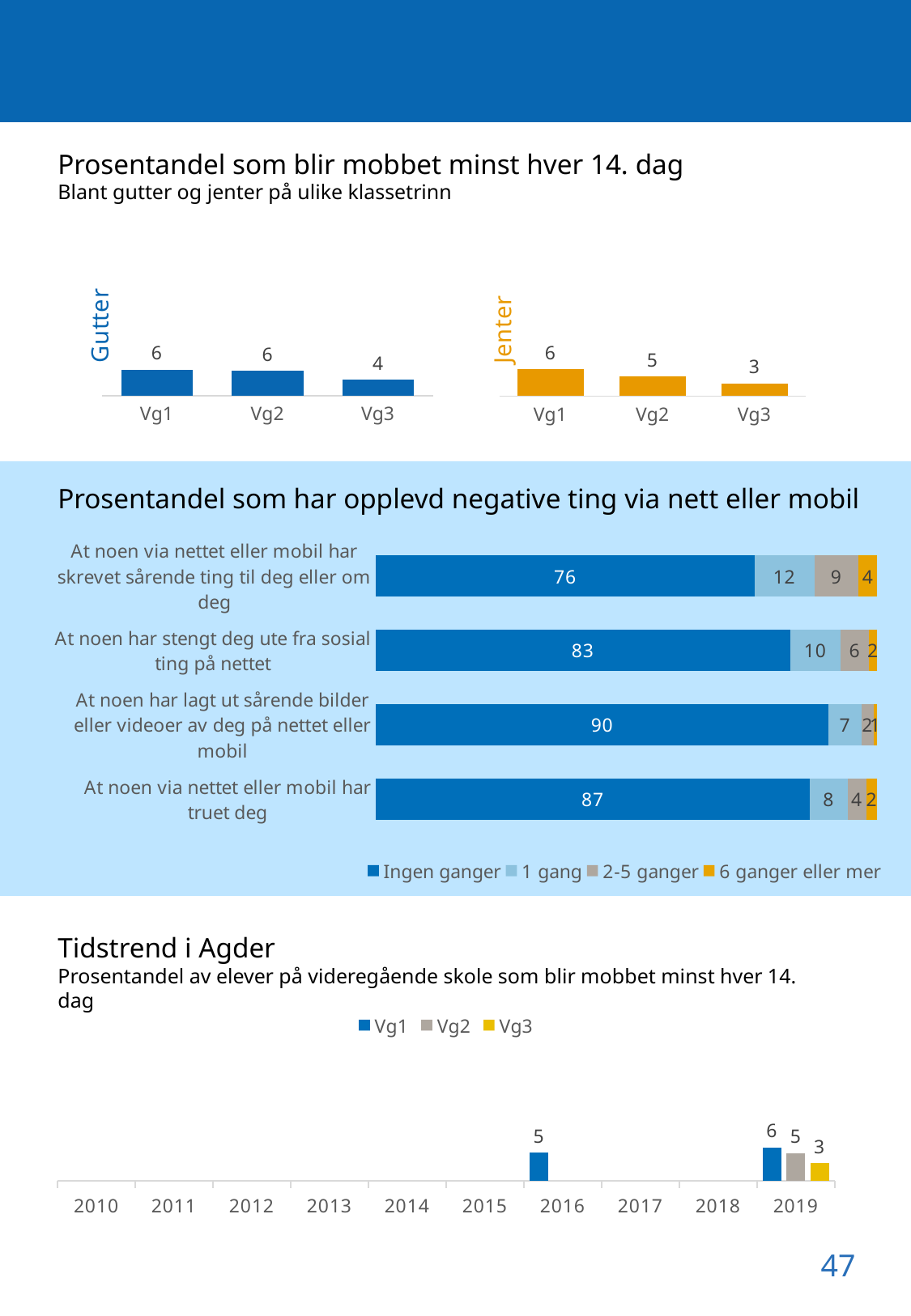
In the chart 'Prosentandel som har opplevd negative ting via nett eller mobil', which category has the highest 'Ingen ganger' value? At noen har lagt ut sårende bilder eller videoer av deg på nettet eller mobil In the 'Gutter' chart at the top, what is the value for Vg3? 4 In the 'Gutter' chart at the top, do the values rise or fall from Vg1 to Vg3? fall In the chart 'Prosentandel som har opplevd negative ting via nett eller mobil', how many series does the legend list? 4 In the 'Tidstrend i Agder' chart, what is the difference between the Vg1 and Vg3 values for 2019? 3 Comparing the top charts, is the Vg2 value larger for Gutter or for Jenter? Gutter In the 'Gutter' chart at the top, what is the difference between the Vg1 and Vg3 values? 2 In the 'Jenter' chart at the top, which category has the lowest value? Vg3 In the 'Jenter' chart at the top, what is the value for Vg2? 5 In the chart 'Prosentandel som har opplevd negative ting via nett eller mobil', what is the '1 gang' value for 'At noen via nettet eller mobil har skrevet sårende ting til deg eller om deg'? 12 In the chart 'Prosentandel som har opplevd negative ting via nett eller mobil', what is the 'Ingen ganger' value for 'At noen har stengt deg ute fra sosial ting på nettet'? 83 In the 'Tidstrend i Agder' chart, what is the Vg1 value for 2019? 6